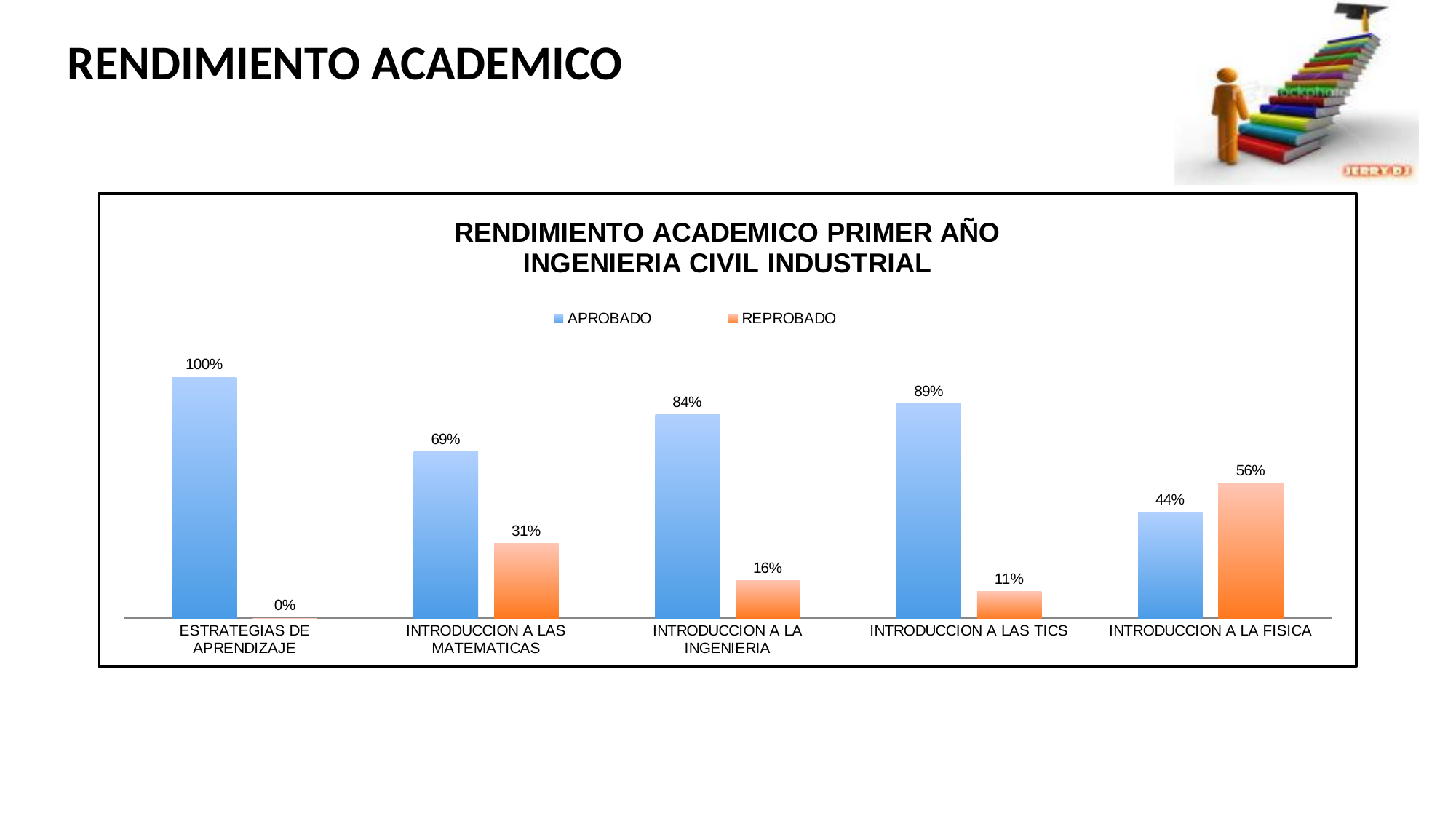
Which category has the highest APROBADO value? ESTRATEGIAS DE APRENDIZAJE What kind of chart is shown on the slide? Bar chart What is the difference between the APROBADO and REPROBADO values for INTRODUCCION A LA INGENIERIA? 68% How many categories are shown on the x axis? 5 How many series does the legend list? 2 What is the APROBADO value for INTRODUCCION A LAS MATEMATICAS? 69% Which category has the lowest APROBADO value? INTRODUCCION A LA FISICA What is the title of the chart? RENDIMIENTO ACADEMICO PRIMER AÑO INGENIERIA CIVIL INDUSTRIAL Which is larger for INTRODUCCION A LA FISICA, the APROBADO value or the REPROBADO value? REPROBADO What is the REPROBADO value for INTRODUCCION A LAS TICS? 11% What is the REPROBADO value for INTRODUCCION A LA FISICA? 56% Which category has the highest REPROBADO value? INTRODUCCION A LA FISICA